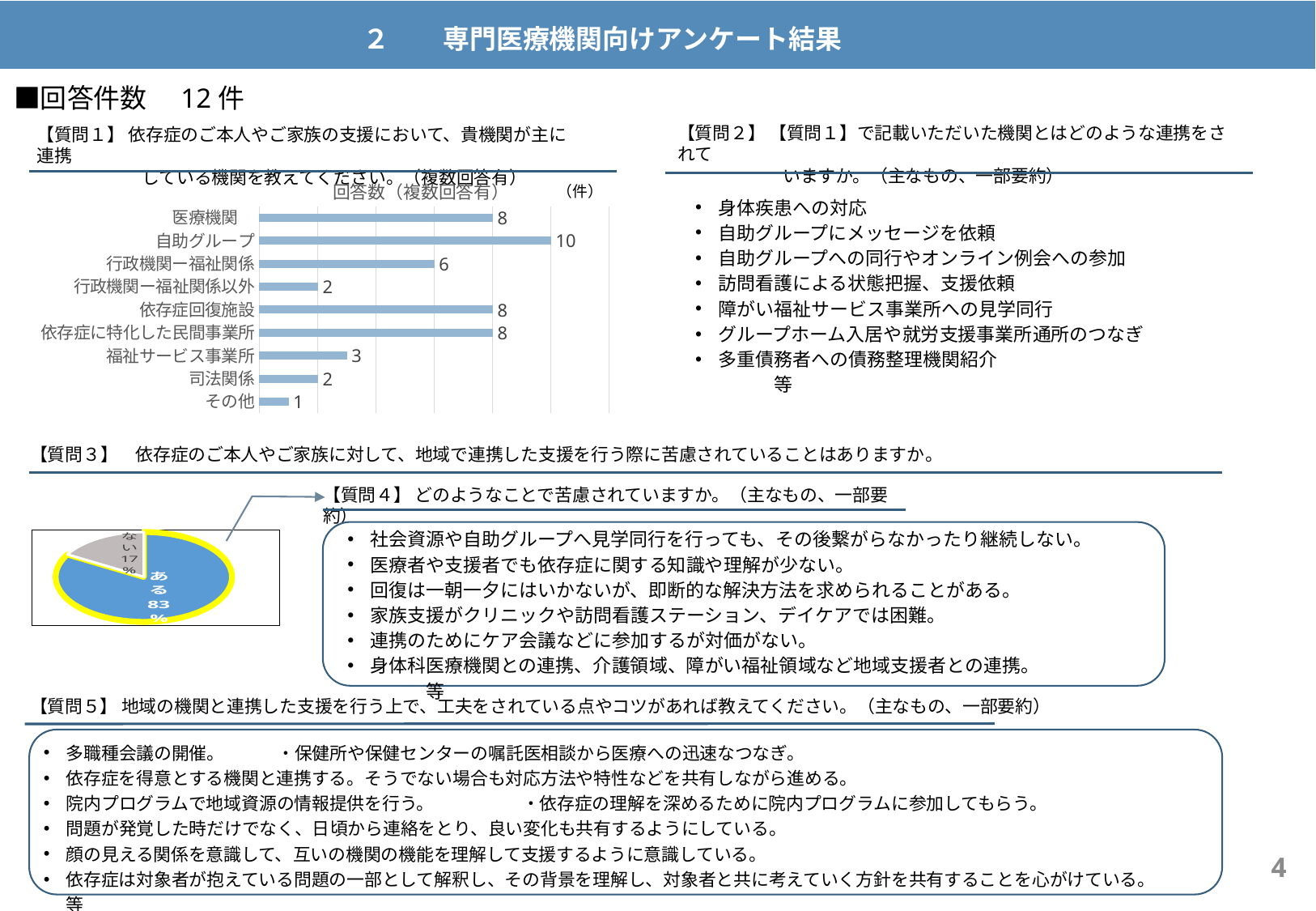
How many categories are shown in the bar chart titled 回答数（複数回答有）? 9 In the bar chart titled 回答数（複数回答有）, what is the difference between the values for 自助グループ and 医療機関? 2 In the bar chart titled 回答数（複数回答有）, what is the value for 行政機関－福祉関係? 6 In the bar chart titled 回答数（複数回答有）, what is the value for 自助グループ? 10 In the bar chart titled 回答数（複数回答有）, what is the value for 福祉サービス事業所? 3 What kind of chart is shown under 【質問３】 on the left of the slide? pie chart What kind of chart is the chart titled 回答数（複数回答有）? bar chart In the pie chart under 【質問３】, what share does the slice ない have? 17% In the bar chart titled 回答数（複数回答有）, which category has the lowest value? その他 In the pie chart under 【質問３】, what share does the slice ある have? 83% In the bar chart titled 回答数（複数回答有）, which category has the highest value? 自助グループ In the bar chart titled 回答数（複数回答有）, which is larger, the value for 行政機関－福祉関係 or the value for 司法関係? 行政機関－福祉関係